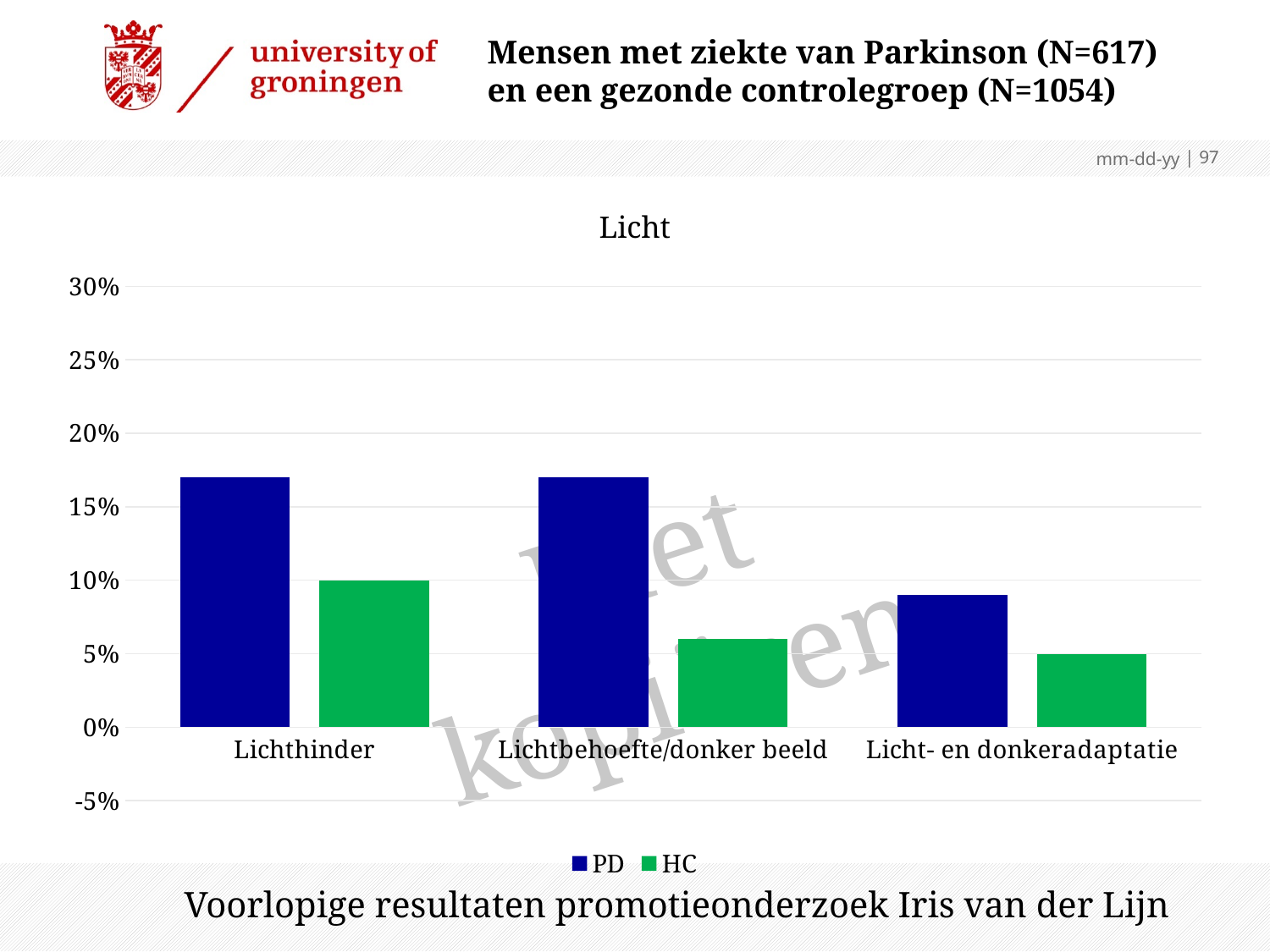
Which category has the highest HC value? Lichthinder For Lichtbehoefte/donker beeld, which is larger, the PD value or the HC value? PD Which category has the lowest PD value? Licht- en donkeradaptatie What kind of chart is shown on the slide? bar chart What is the HC value for Lichthinder? 10% Is the PD value for Lichthinder greater or less than 15%? greater What is the title of the chart? Licht Which two series are listed in the legend? PD and HC What is the HC value for Licht- en donkeradaptatie? 5% How many series does the legend list? 2 How many categories are shown on the x axis? 3 Is the PD value for Licht- en donkeradaptatie greater or less than 10%? less